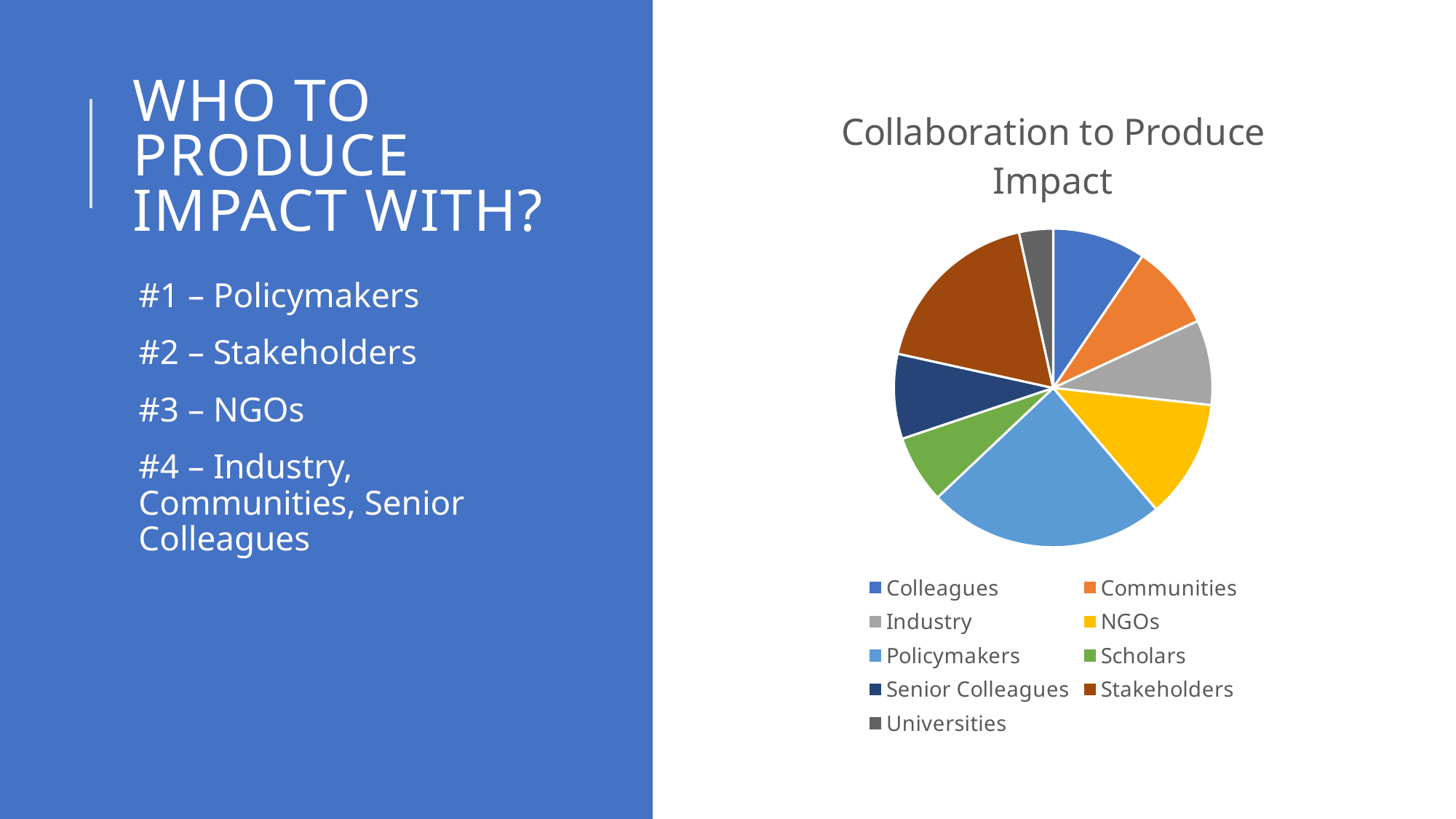
What kind of chart is shown on the slide? pie chart Which slice is larger, Policymakers or Scholars? Policymakers Which category is shown in light blue in the pie chart? Policymakers Which slice is larger, Stakeholders or Universities? Stakeholders Which slice is larger, Stakeholders or Senior Colleagues? Stakeholders Which category has the smallest slice of the pie? Universities How many categories does the pie chart's legend list? 9 What is the title of the chart? Collaboration to Produce Impact Which category has the largest slice of the pie? Policymakers